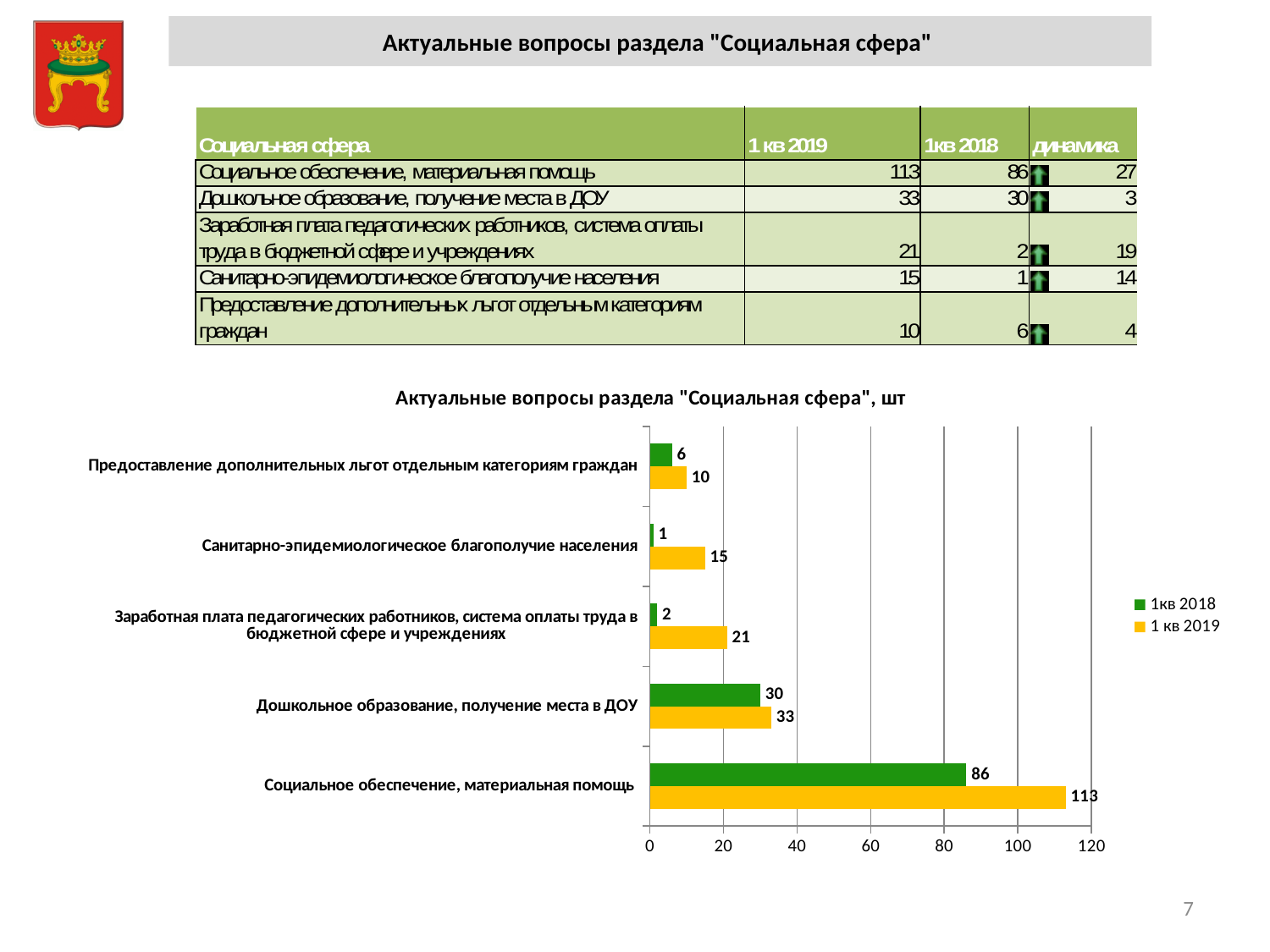
What kind of chart is shown on the slide? bar chart What is the difference between the '1 кв 2019' and '1кв 2018' values for 'Социальное обеспечение, материальная помощь'? 27 What is the value for 'Социальное обеспечение, материальная помощь' in the '1 кв 2019' series? 113 Which is larger for 'Предоставление дополнительных льгот отдельным категориям граждан': the '1кв 2018' value or the '1 кв 2019' value? 1 кв 2019 How many categories are shown in the chart? 5 Which category has the highest value in the '1 кв 2019' series? Социальное обеспечение, материальная помощь How many series does the legend list? 2 What is the value for 'Санитарно-эпидемиологическое благополучие населения' in the '1 кв 2019' series? 15 What is the difference between the '1 кв 2019' and '1кв 2018' values for 'Заработная плата педагогических работников, система оплаты труда в бюджетной сфере и учреждениях'? 19 Is the '1 кв 2019' value for 'Социальное обеспечение, материальная помощь' greater or less than 100? greater What is the value for 'Дошкольное образование, получение места в ДОУ' in the '1кв 2018' series? 30 Which category has the lowest value in the '1кв 2018' series? Санитарно-эпидемиологическое благополучие населения